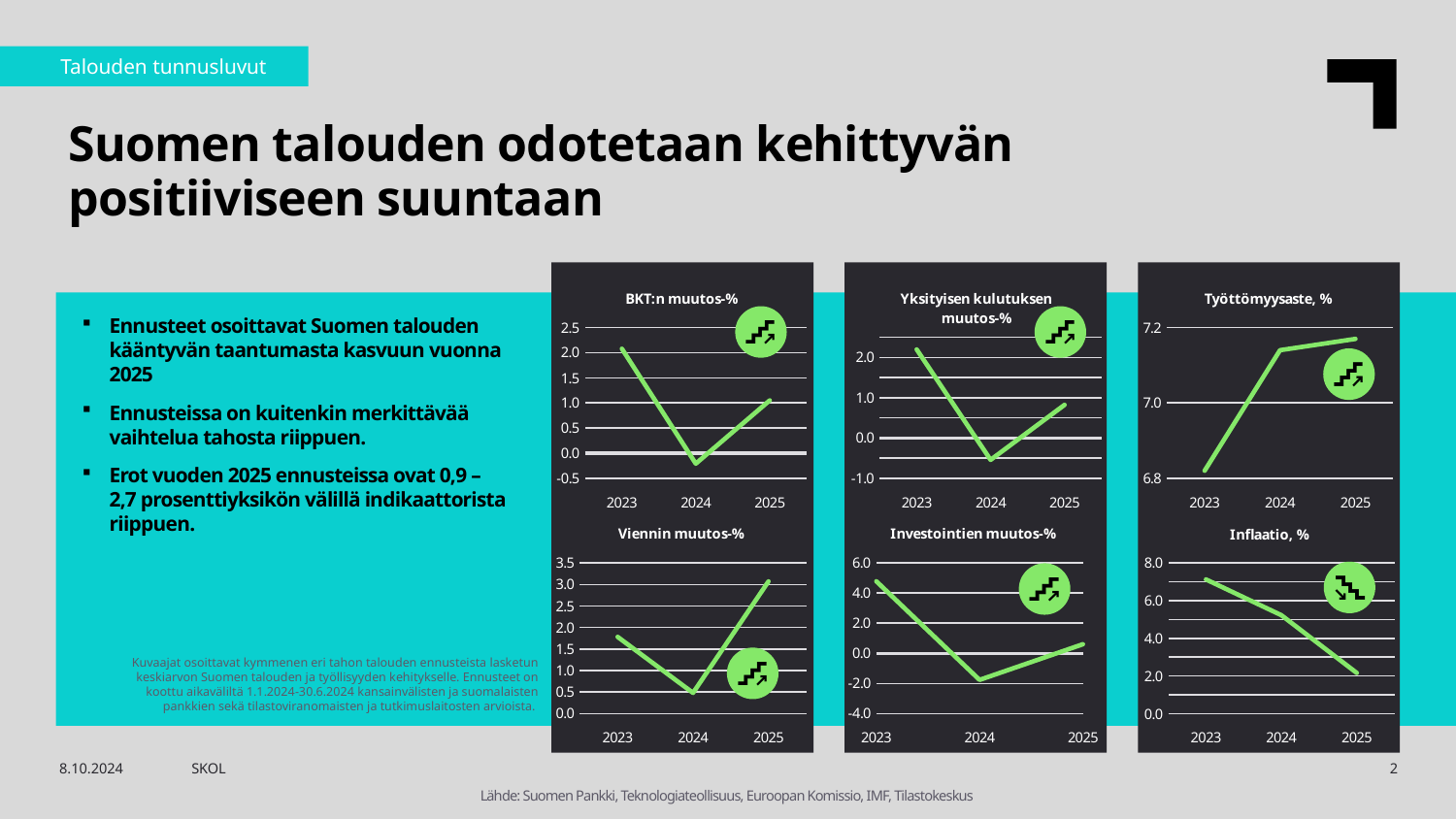
In the "Työttömyysaste, %" chart, do the values rise or fall from 2023 to 2025? rise How many charts are shown on the slide? 6 What kind of chart is the "BKT:n muutos-%" chart? line chart In the "Viennin muutos-%" chart, is the value for 2025 greater or less than 2.5? greater In the "Inflaatio, %" chart, do the values rise or fall from 2023 to 2025? fall In the "Työttömyysaste, %" chart, is the value for 2024 greater or less than 7.0? greater How many data points are plotted in the "Inflaatio, %" chart? 3 In the "Yksityisen kulutuksen muutos-%" chart, is the value for 2025 greater or less than 1.0? less In the "Viennin muutos-%" chart, which year has the highest value? 2025 In the "BKT:n muutos-%" chart, which year has the lowest value? 2024